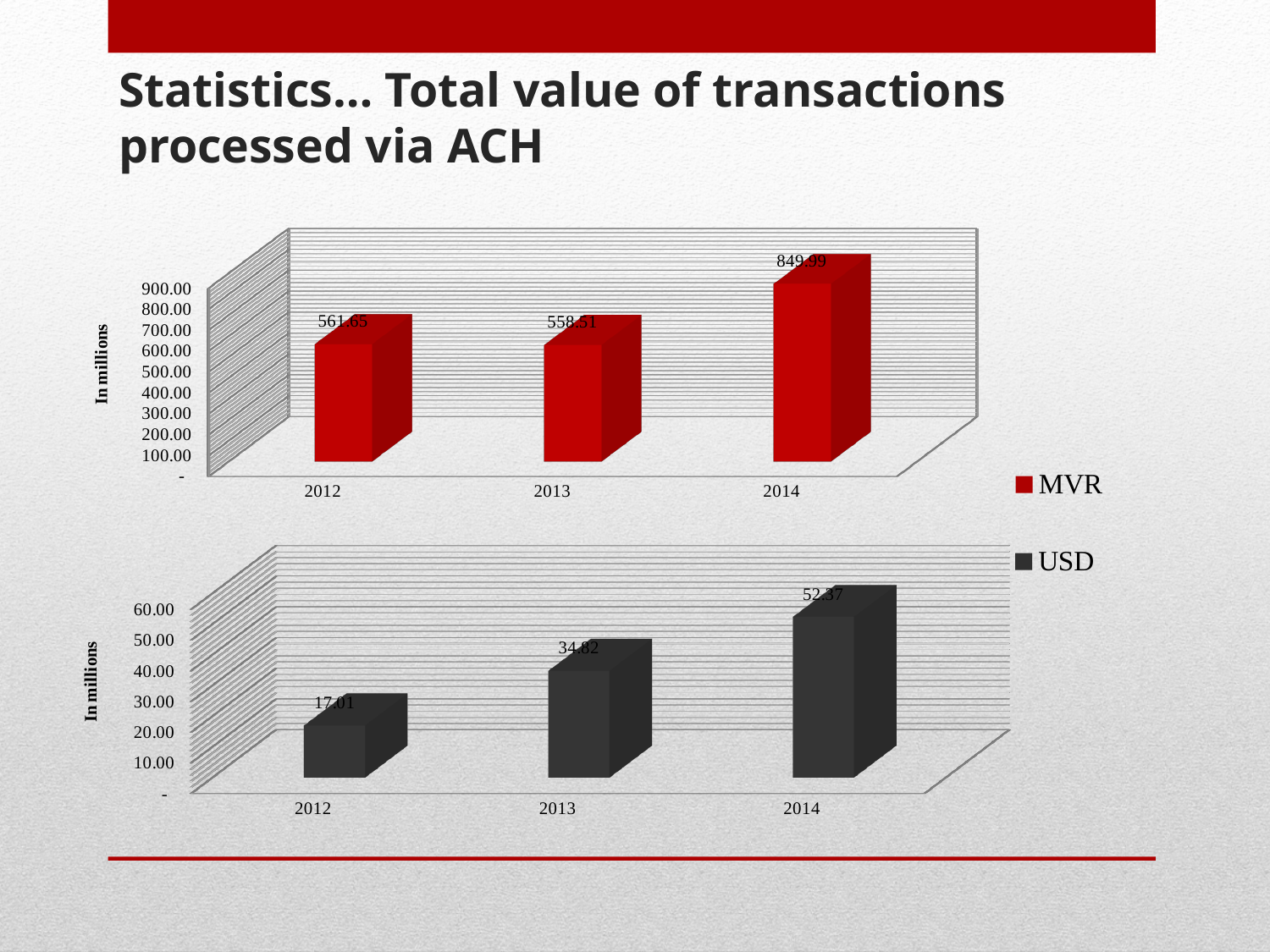
In the top (MVR) chart, what is the value for 2012? 561.65 In the bottom (USD) chart, which year has the lowest value? 2012 In the top (MVR) chart, what is the value for 2014? 849.99 How many years are shown on the x axis of the top (MVR) chart? 3 In the bottom (USD) chart, which is larger, the value for 2013 or the value for 2014? 2014 In the bottom (USD) chart, what is the value for 2013? 34.82 In the bottom (USD) chart, do the values rise or fall from 2012 to 2014? rise What kind of chart is the bottom (USD) chart? bar chart In the bottom (USD) chart, what is the value for 2012? 17.01 In the top (MVR) chart, which year has the highest value? 2014 In the bottom (USD) chart, what is the difference between the 2014 and 2012 values? 35.36 In the top (MVR) chart, what is the difference between the 2014 and 2012 values? 288.34